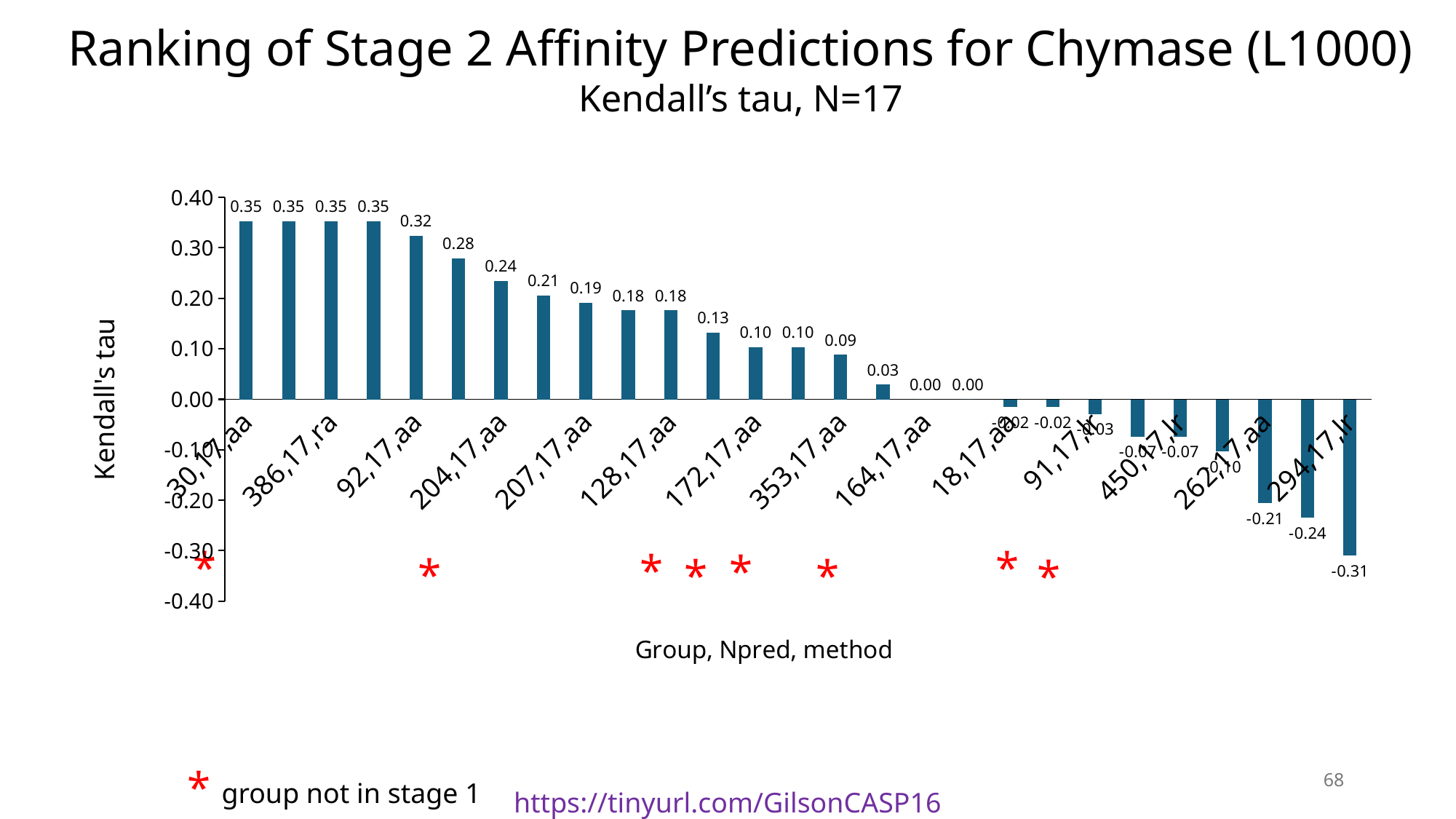
What is the Kendall's tau value for 92,17,aa? 0.32 What is the highest Kendall's tau value shown on the chart? 0.35 Do the bar values rise or fall from left to right along the x axis? fall What type of chart is shown on the slide? bar chart Which group has the lowest Kendall's tau on the chart? 294,17,lr What is the Kendall's tau value for 294,17,lr? -0.31 What is the title of the y axis? Kendall's tau What is the lowest Kendall's tau value shown on the chart? -0.31 What is the difference between the highest value (0.35) and the lowest value (-0.31) on the chart? 0.66 What is the Kendall's tau value for 164,17,aa? 0.00 What is the Kendall's tau value for 30,17,aa? 0.35 Which has a larger Kendall's tau, 204,17,aa or 128,17,aa? 204,17,aa